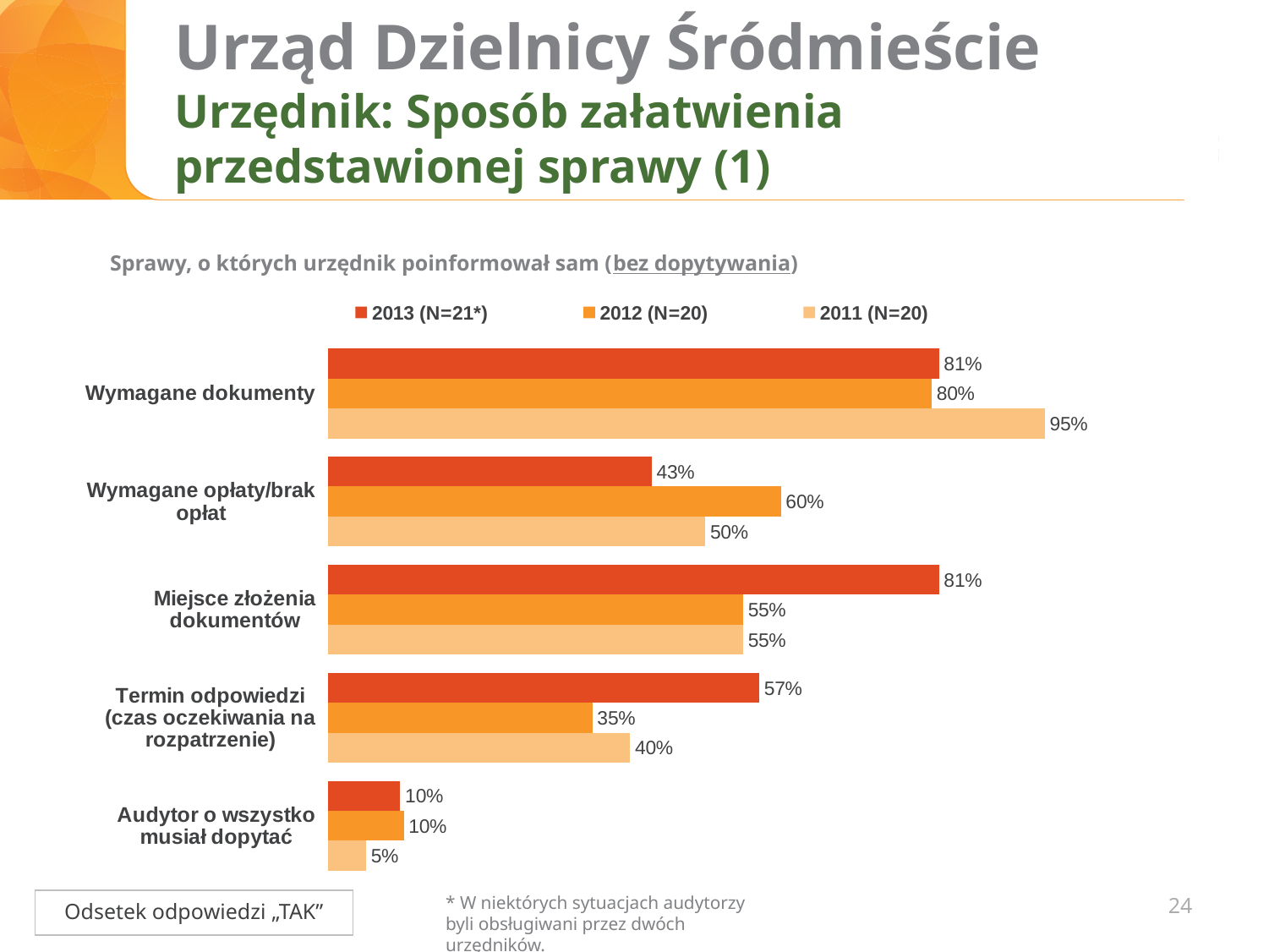
For "Wymagane opłaty/brak opłat", which series has the larger value: 2012 (N=20) or 2011 (N=20)? 2012 (N=20) Which category has the lowest value in the 2011 (N=20) series? Audytor o wszystko musiał dopytać Which category has the highest value in the 2012 (N=20) series? Wymagane dokumenty Which series is shown in the darkest red-orange colour in the legend? 2013 (N=21*) How many series does the legend list? 3 What is the value for "Wymagane dokumenty" in the 2011 (N=20) series? 95% How many categories are shown on the chart? 5 What is the difference between the 2013 (N=21*) and 2012 (N=20) values for "Miejsce złożenia dokumentów"? 26% What is the value for "Termin odpowiedzi (czas oczekiwania na rozpatrzenie)" in the 2012 (N=20) series? 35% What is the difference between the 2011 (N=20) and 2013 (N=21*) values for "Wymagane dokumenty"? 14% What kind of chart is shown on the slide? bar chart What is the value for "Wymagane opłaty/brak opłat" in the 2013 (N=21*) series? 43%